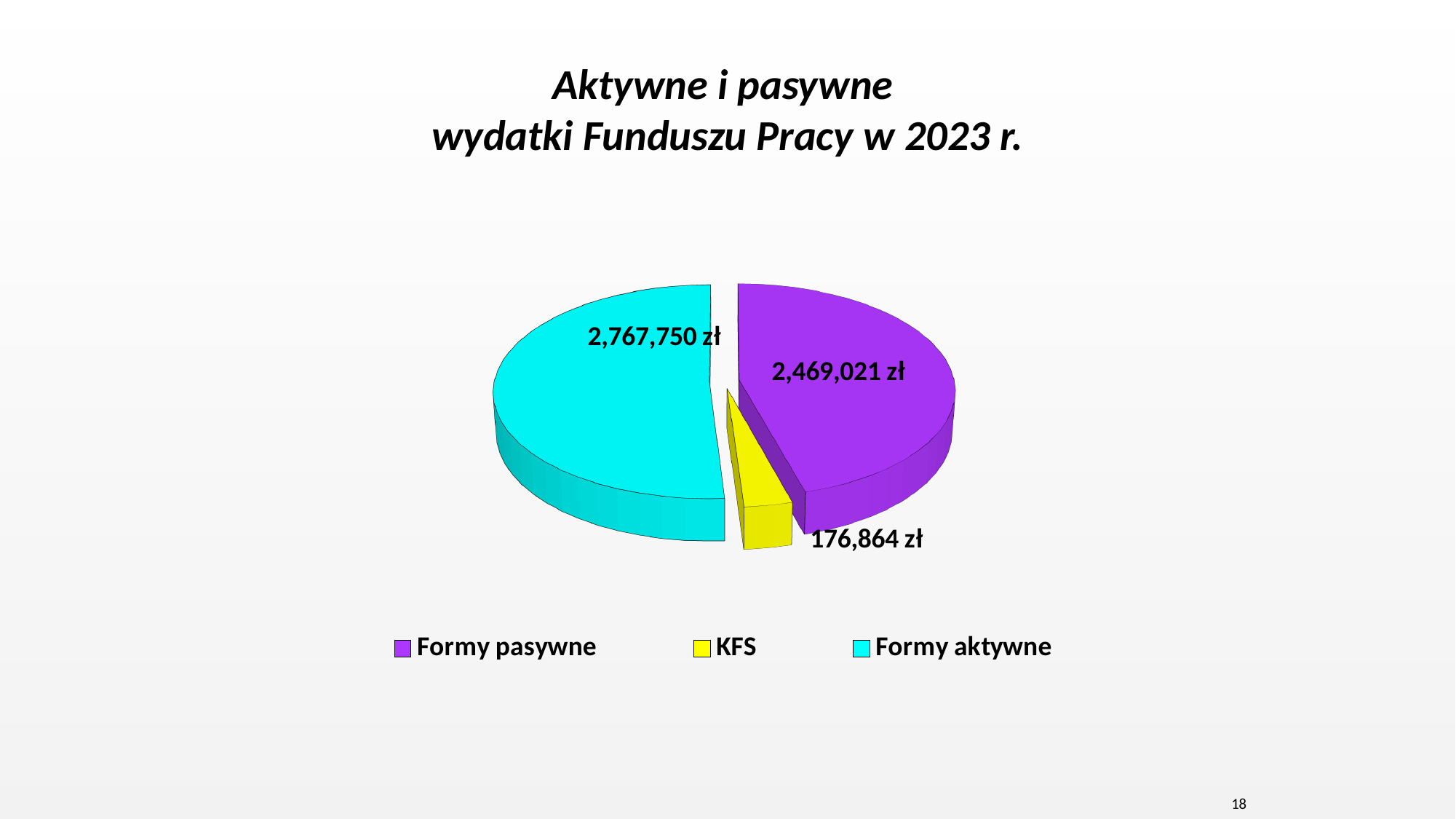
What is the value for KFS? 176,864 zł Which category has the largest slice of the pie? Formy aktywne What is the value for Formy pasywne? 2,469,021 zł What is the difference between the values for Formy aktywne and Formy pasywne? 298,729 zł Which category has the smallest slice of the pie? KFS What colour is the slice for KFS? Yellow What is the title of the chart? Aktywne i pasywne wydatki Funduszu Pracy w 2023 r. How many slices does the pie chart have? 3 Which is larger, Formy aktywne or Formy pasywne? Formy aktywne What is the difference between the values for Formy pasywne and KFS? 2,292,157 zł What type of chart is shown on the slide? Pie chart What is the value for Formy aktywne? 2,767,750 zł